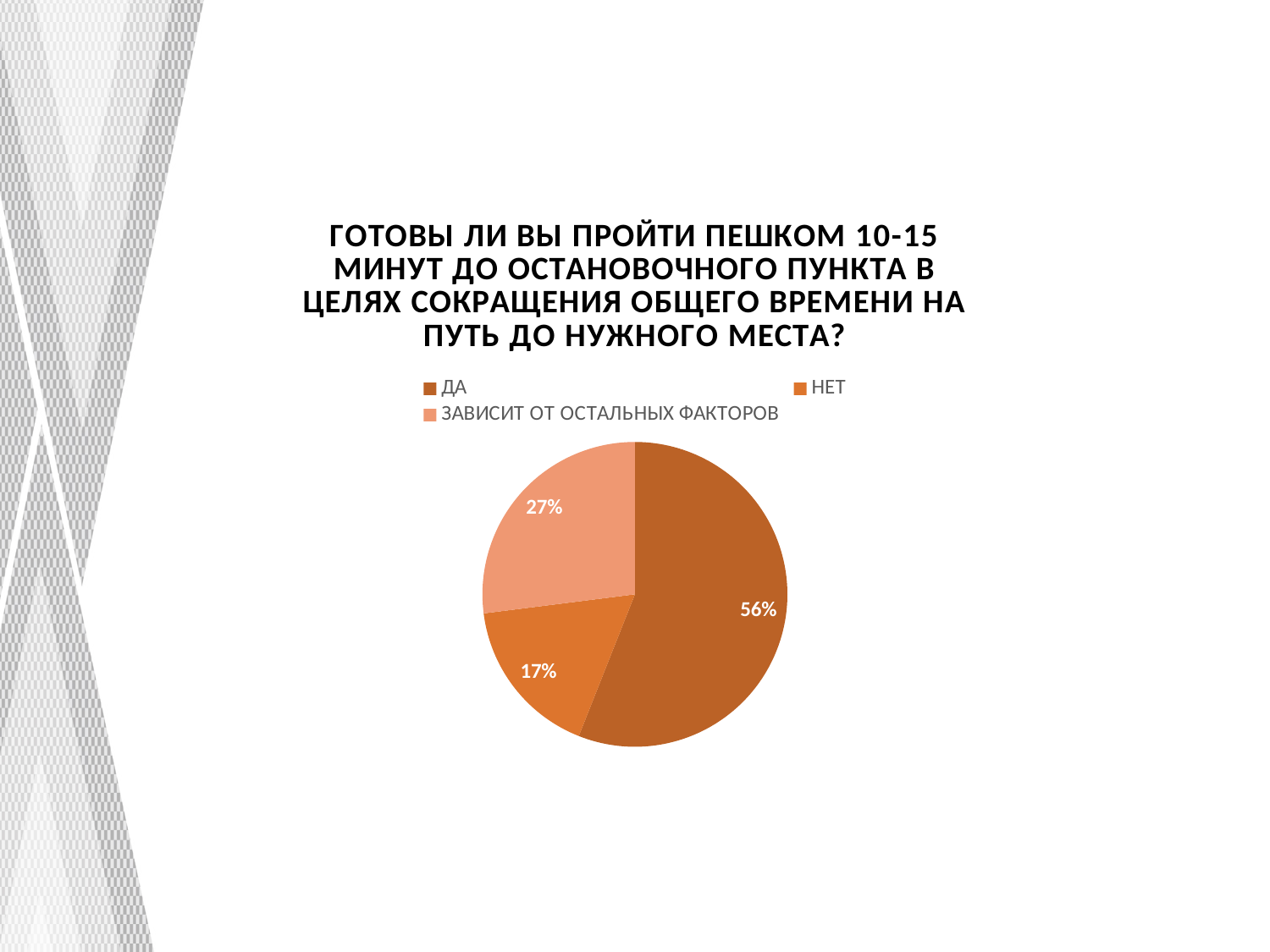
What share of the pie does the "ЗАВИСИТ ОТ ОСТАЛЬНЫХ ФАКТОРОВ" slice represent? 27% How many entries does the legend list? 3 What is the difference in percentage points between the "ЗАВИСИТ ОТ ОСТАЛЬНЫХ ФАКТОРОВ" slice and the "НЕТ" slice? 10 What kind of chart is shown on the slide? Pie chart What share of the pie does the "ДА" slice represent? 56% What is the difference in percentage points between the "ДА" slice and the "НЕТ" slice? 39 Which legend entry is shown in the lightest shade of orange? ЗАВИСИТ ОТ ОСТАЛЬНЫХ ФАКТОРОВ Which category has the smallest slice of the pie? НЕТ What share of the pie does the "НЕТ" slice represent? 17% How many slices does the pie chart have? 3 Which category has the largest slice of the pie? ДА Which is larger, the "НЕТ" slice or the "ЗАВИСИТ ОТ ОСТАЛЬНЫХ ФАКТОРОВ" slice? ЗАВИСИТ ОТ ОСТАЛЬНЫХ ФАКТОРОВ